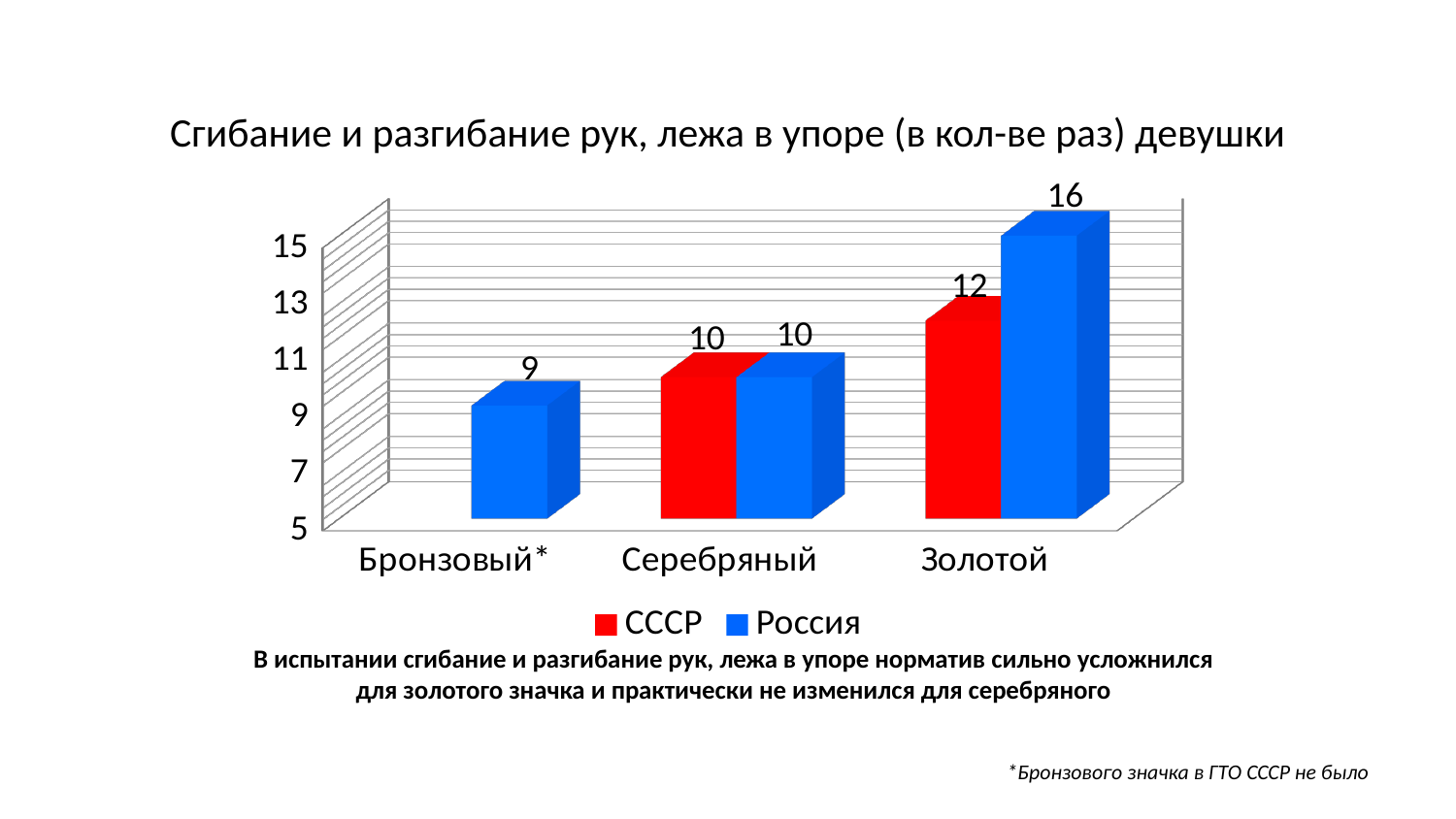
What is the value for Россия in the Золотой category? 16 What is the value for СССР in the Золотой category? 12 How many categories are shown on the x axis? 3 Which category has the highest value for Россия? Золотой How many series does the legend list? 2 Which category has the lowest value for Россия? Бронзовый Which colour represents the СССР series? Red What is the difference between the Россия and СССР values in the Золотой category? 4 What kind of chart is shown on the slide? Bar chart What is the value for СССР in the Серебряный category? 10 Which is larger in the Золотой category: the value for СССР or for Россия? Россия What is the value for Россия in the Бронзовый category? 9